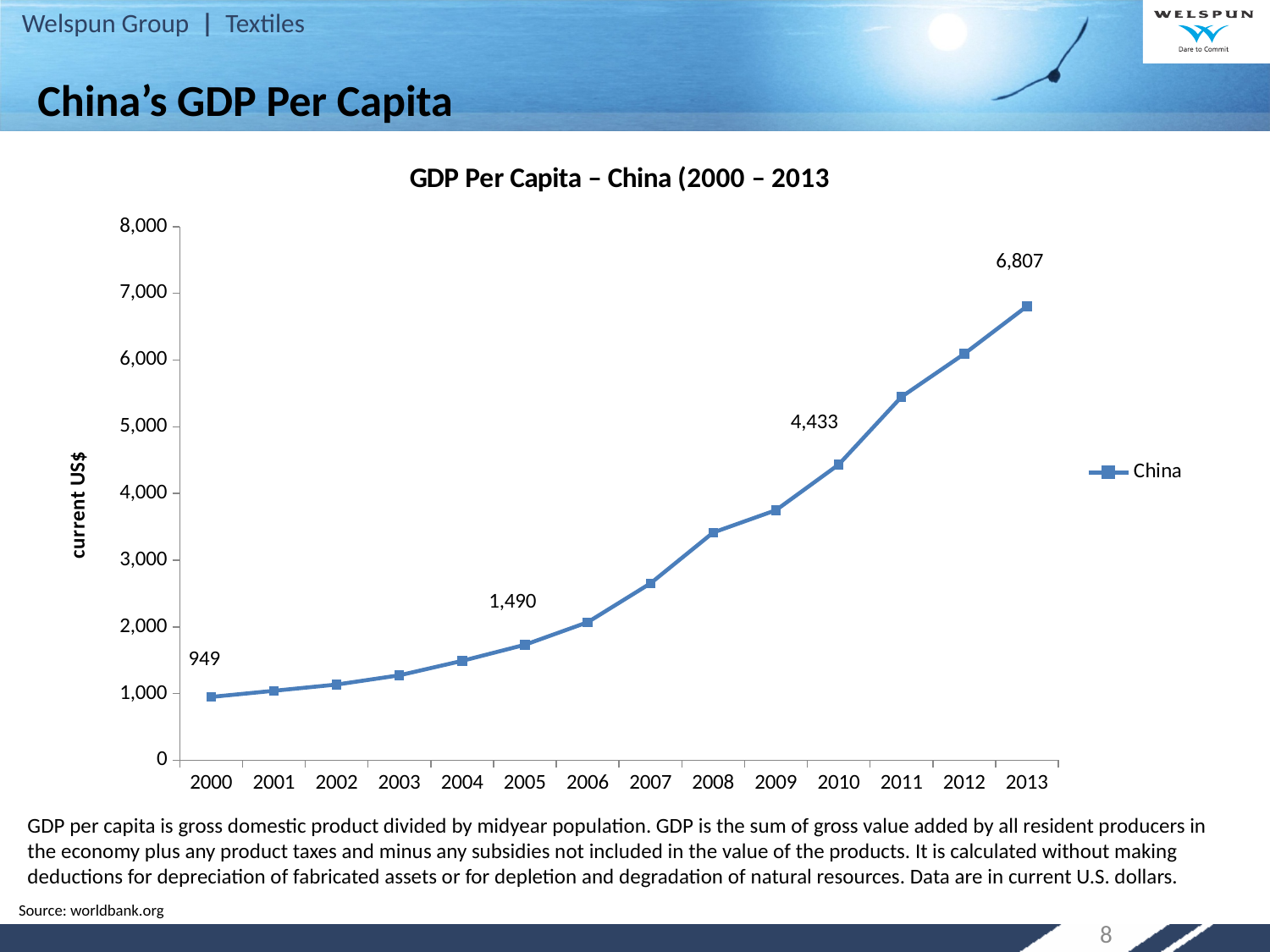
How many series does the legend list? 1 What is the difference between the GDP per capita in 2013 and in 2000? 5,858 What is the title of the chart? GDP Per Capita – China (2000 – 2013 How many years are plotted on the x axis of the chart? 14 Which year has the lowest GDP per capita on the chart? 2000 What is China's GDP per capita in 2000 according to the chart? 949 What is China's GDP per capita in 2013 according to the chart? 6,807 What type of chart is shown on the slide? line chart Is the value for 2008 greater or less than 3,000? greater Does China's GDP per capita rise or fall from 2000 to 2013? rise Which year has the highest GDP per capita on the chart? 2013 Is the value for 2011 greater or less than 5,000? greater